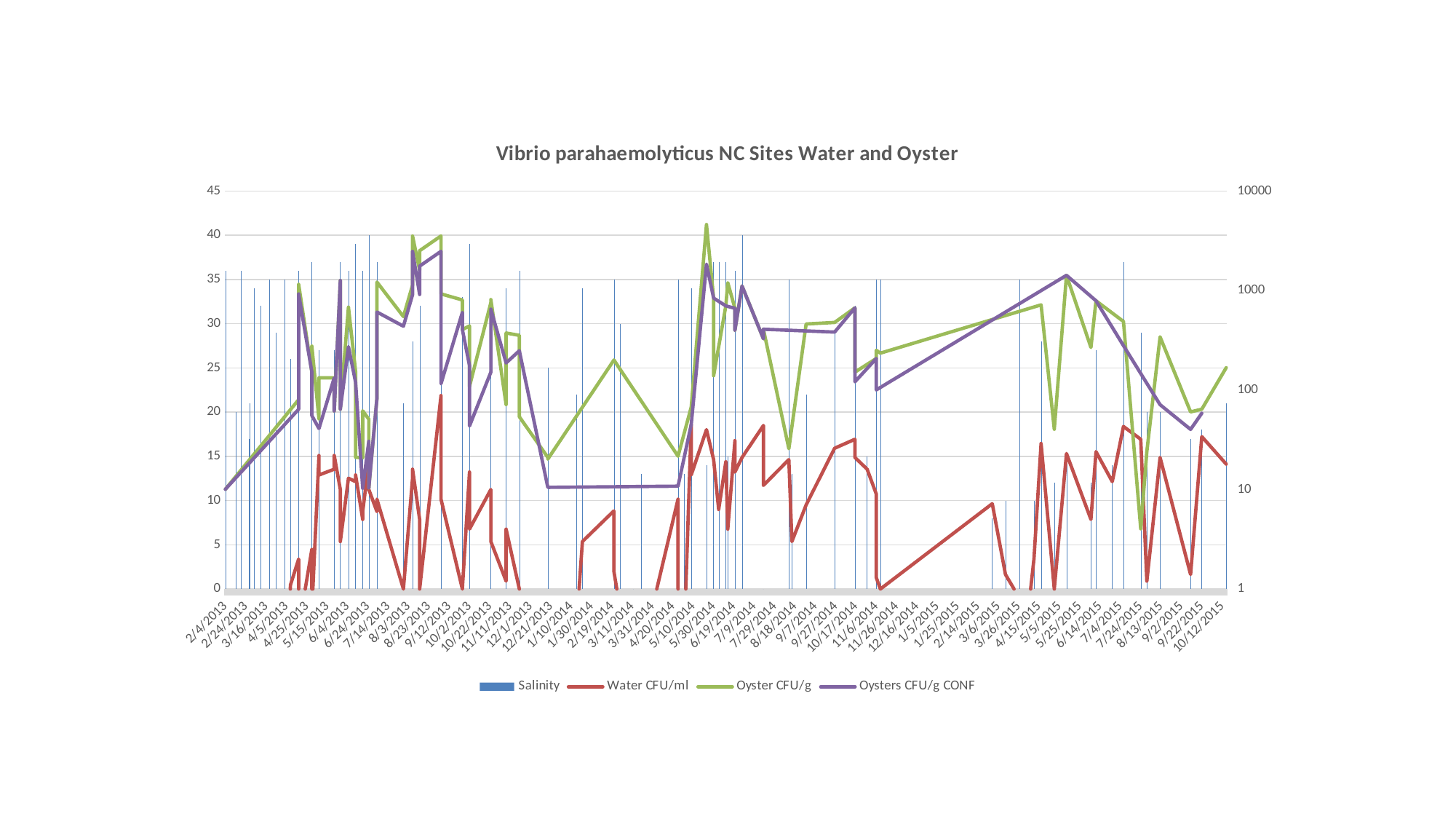
What is the highest tick value shown on the right-hand axis? 10000 What is the last date label on the x axis? 10/12/2015 Between 11/26/2014 and 5/25/2015, does the Oysters CFU/g CONF line rise or fall? rise Is the Oysters CFU/g CONF value around 2/19/2014 greater or less than 100 on the right axis? less What is the highest tick value shown on the left-hand axis? 45 Is the highest point of the Oyster CFU/g line greater or less than 1000 on the right axis? greater What is the title of the chart? Vibrio parahaemolyticus NC Sites Water and Oyster What is the first date label on the x axis? 2/4/2013 Which series is drawn in green? Oyster CFU/g What kind of chart is used to plot the Water CFU/ml series? Line chart How many series does the legend list? 4